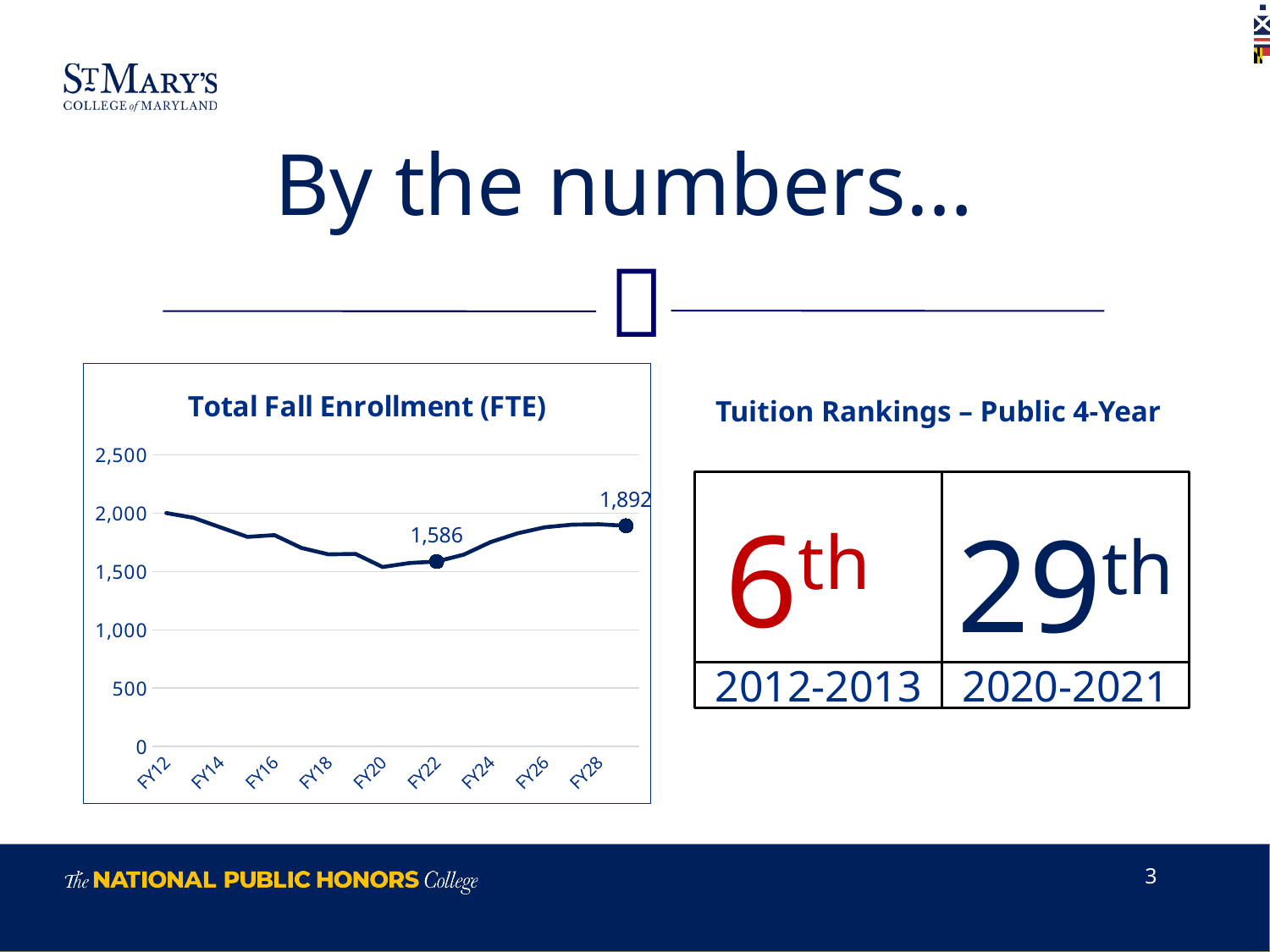
What is the highest value shown on the y axis of the Total Fall Enrollment (FTE) chart? 2,500 Is the value for FY12 in the Total Fall Enrollment (FTE) chart greater or less than 1,500? greater Is the value for FY16 in the Total Fall Enrollment (FTE) chart greater or less than 1,500? greater How many fiscal year labels are shown on the x axis of the Total Fall Enrollment (FTE) chart? 9 Which is larger in the Total Fall Enrollment (FTE) chart, the value for FY22 or the value for FY28? FY28 Is the value for FY20 in the Total Fall Enrollment (FTE) chart greater or less than 2,000? less Do the values in the Total Fall Enrollment (FTE) chart rise or fall from FY22 to FY28? rise Do the values in the Total Fall Enrollment (FTE) chart rise or fall from FY12 to FY20? fall What is the value for FY22 in the Total Fall Enrollment (FTE) chart? 1,586 What kind of chart is the Total Fall Enrollment (FTE) chart? line chart